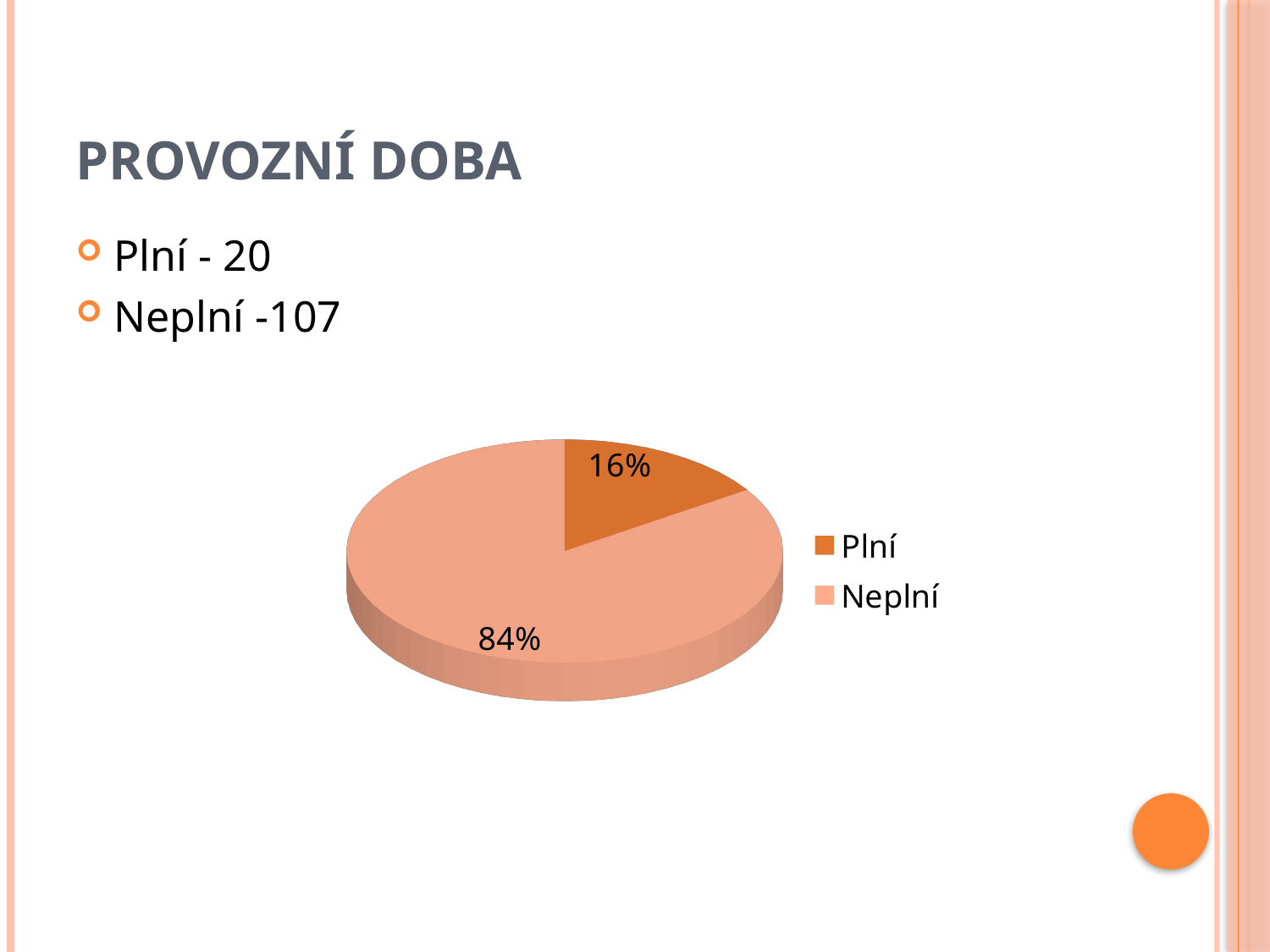
What percentage does the Plní slice show? 16% What share of the pie does the Neplní slice take? 84% What is the difference in percentage points between the Neplní and Plní slices? 68 What percentage does the Neplní slice show? 84% How many slices does the pie chart have? 2 Which slice is the smallest in the pie chart? Plní How many entries does the legend list? 2 What is the title of the slide containing the pie chart? PROVOZNÍ DOBA Which legend entry is shown in the darker orange colour? Plní Which slice is larger, Plní or Neplní? Neplní Which slice is the largest in the pie chart? Neplní What kind of chart is shown on the slide? pie chart